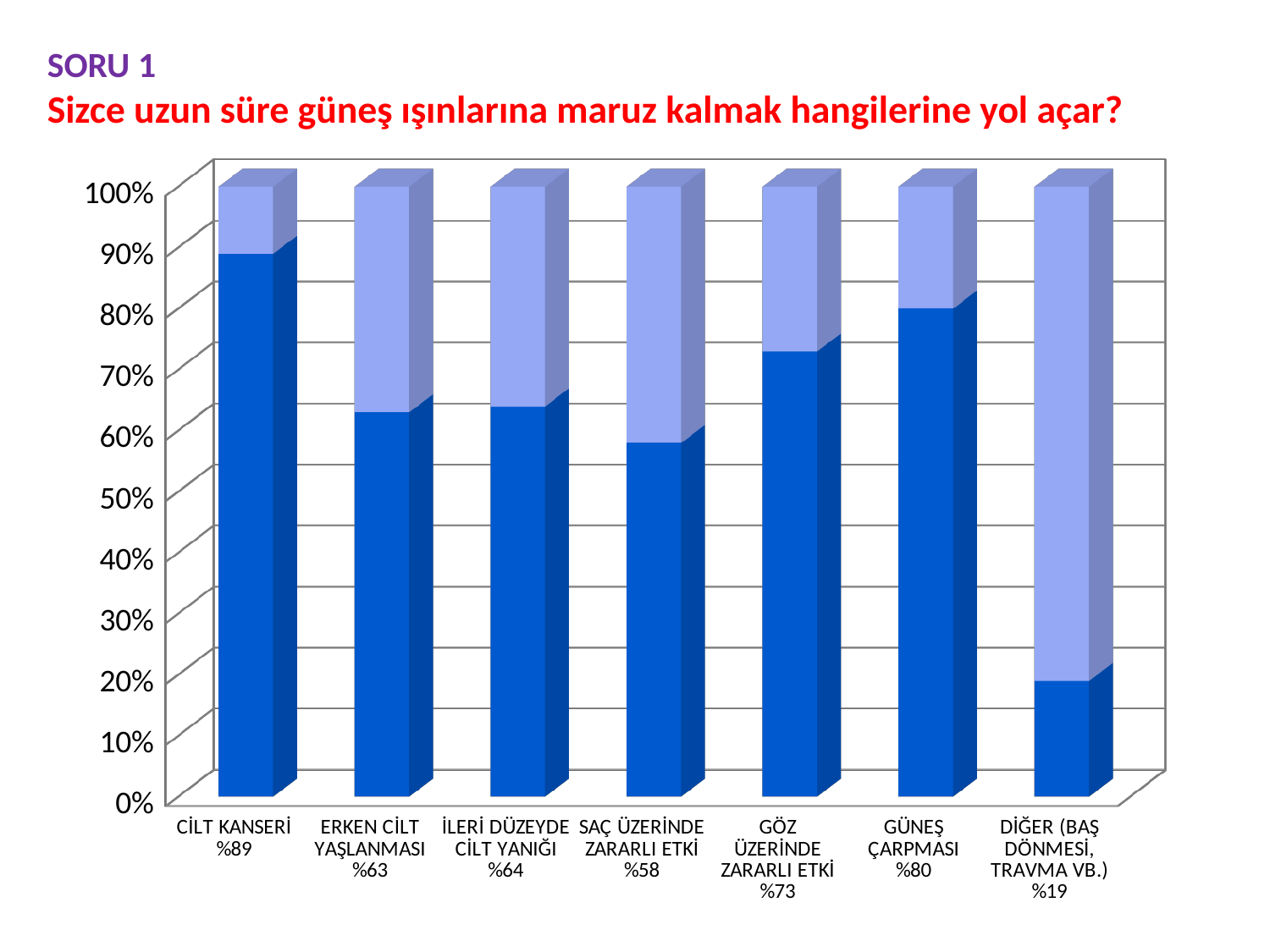
What percentage is shown for SAÇ ÜZERİNDE ZARARLI ETKİ? %58 What percentage is shown for DİĞER (BAŞ DÖNMESİ, TRAVMA VB.)? %19 What is the difference between the percentages for CİLT KANSERİ and DİĞER (BAŞ DÖNMESİ, TRAVMA VB.)? %70 Which category has the lowest percentage? DİĞER (BAŞ DÖNMESİ, TRAVMA VB.) How many categories are shown on the x axis? 7 What is the total height of each stacked bar? 100% What kind of chart is shown on the slide? stacked bar chart Is the dark blue value for ERKEN CİLT YAŞLANMASI greater or less than 50%? greater Which has a higher percentage, GÜNEŞ ÇARPMASI or GÖZ ÜZERİNDE ZARARLI ETKİ? GÜNEŞ ÇARPMASI What percentage is shown for CİLT KANSERİ? %89 Which category has the highest percentage? CİLT KANSERİ What percentage is shown for GÜNEŞ ÇARPMASI? %80